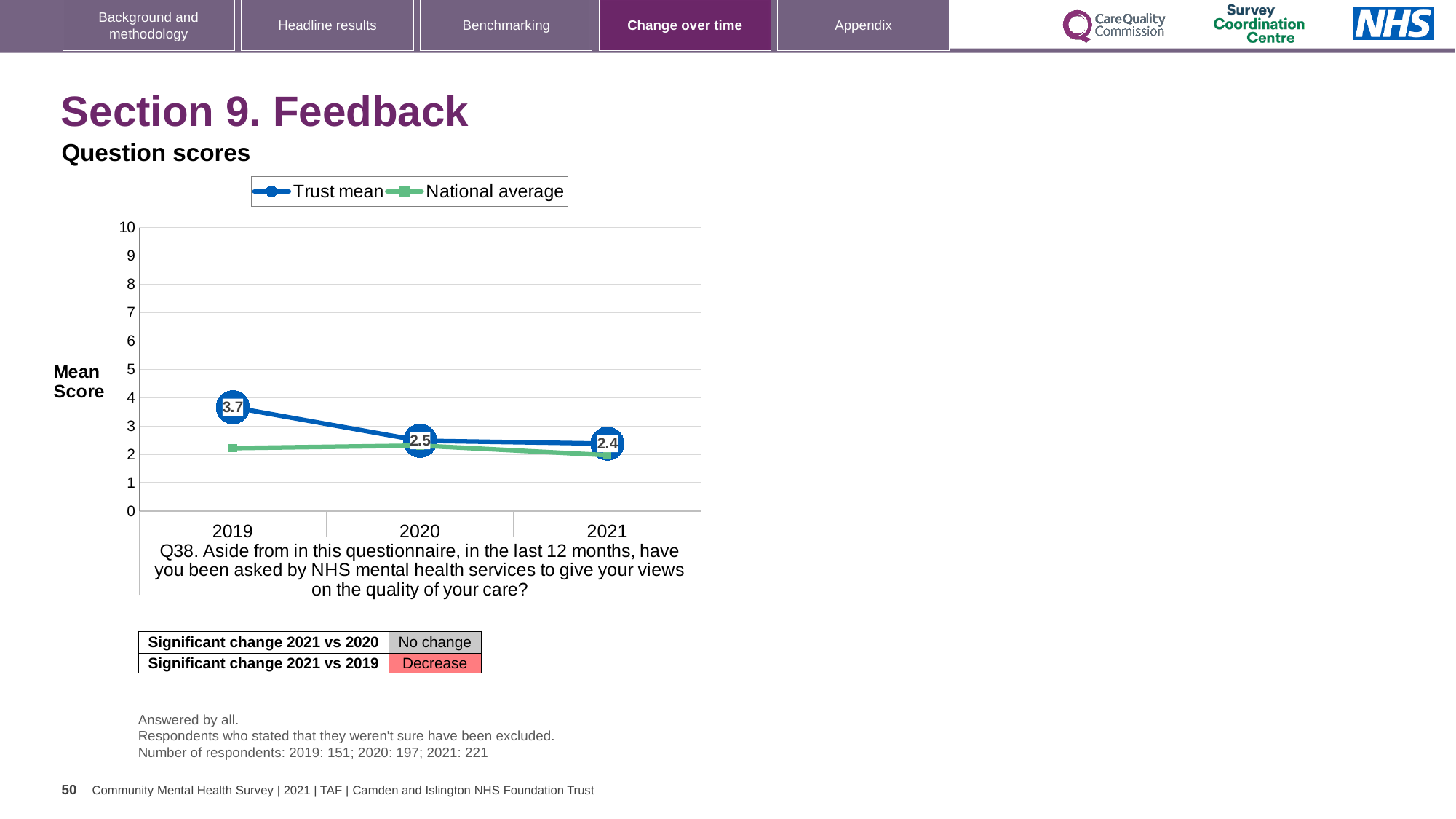
What is the Trust mean score for 2020? 2.5 Does the Trust mean score rise or fall from 2019 to 2021? fall In which year is the Trust mean score lowest? 2021 In which year is the Trust mean score highest? 2019 Which is larger, the Trust mean score in 2019 or in 2020? 2019 What kind of chart is shown on the slide? line chart What is the difference between the Trust mean score in 2019 and in 2021? 1.3 What is the Trust mean score for 2021? 2.4 What is the Trust mean score for 2019? 3.7 How many series does the legend list? 2 Is the National average value for 2019 greater or less than 3? less How many years are plotted on the x axis? 3